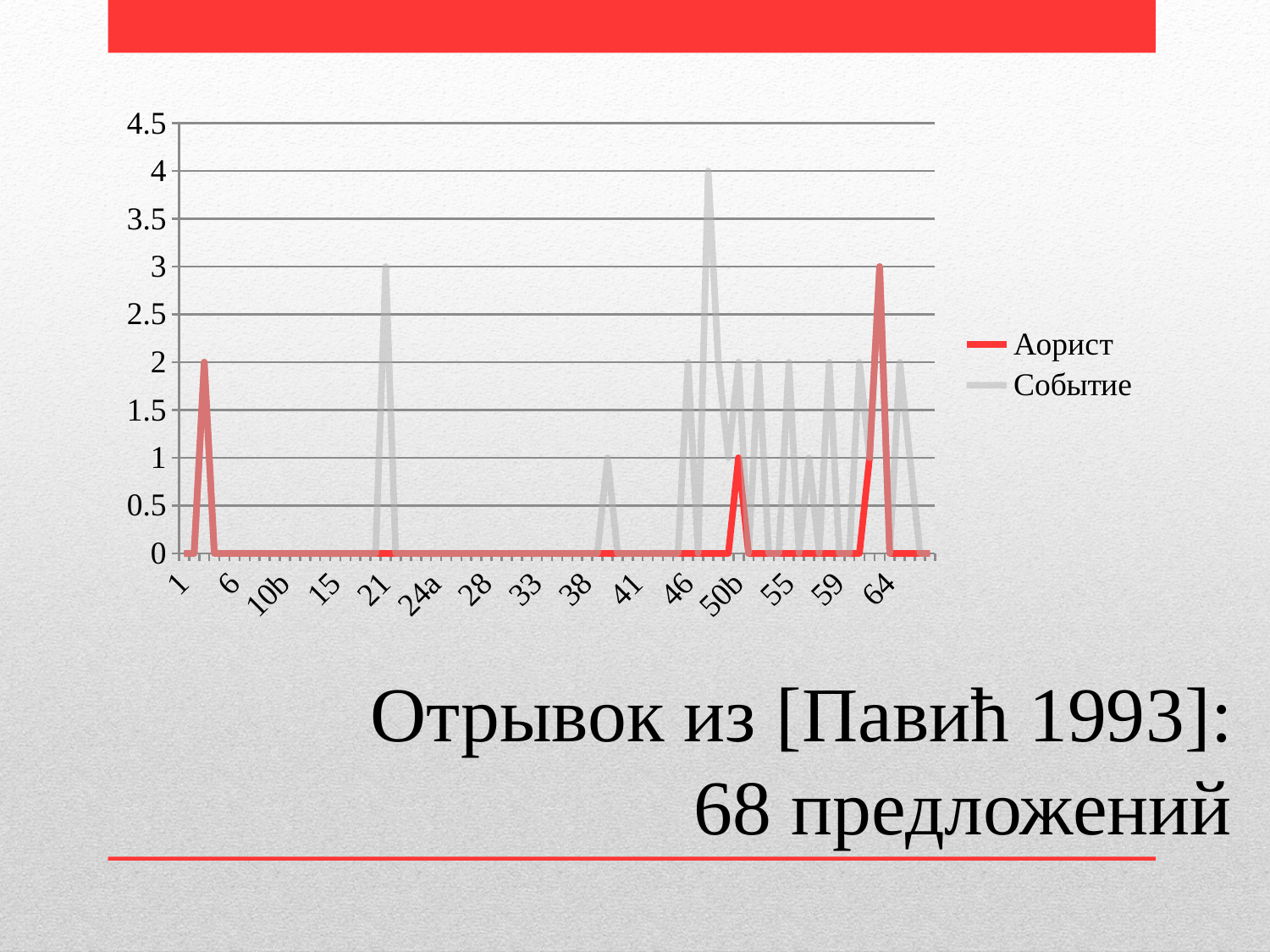
What is the highest tick shown on the vertical axis? 4.5 What is the highest value reached by the Событие series? 4 What is the difference between the peak value of Событие and the peak value of Аорист? 1 Which series reaches a higher peak, Аорист or Событие? Событие What is the value of the Событие series at category 28? 0 What are the two series named in the legend? Аорист and Событие What is the highest value reached by the Аорист series? 3 What kind of chart is shown on the slide? line chart What is the value of the Аорист series at category 15? 0 How many series does the legend list? 2 Is the peak value of the Событие series greater or less than 3.5? greater Which series is drawn in red? Аорист